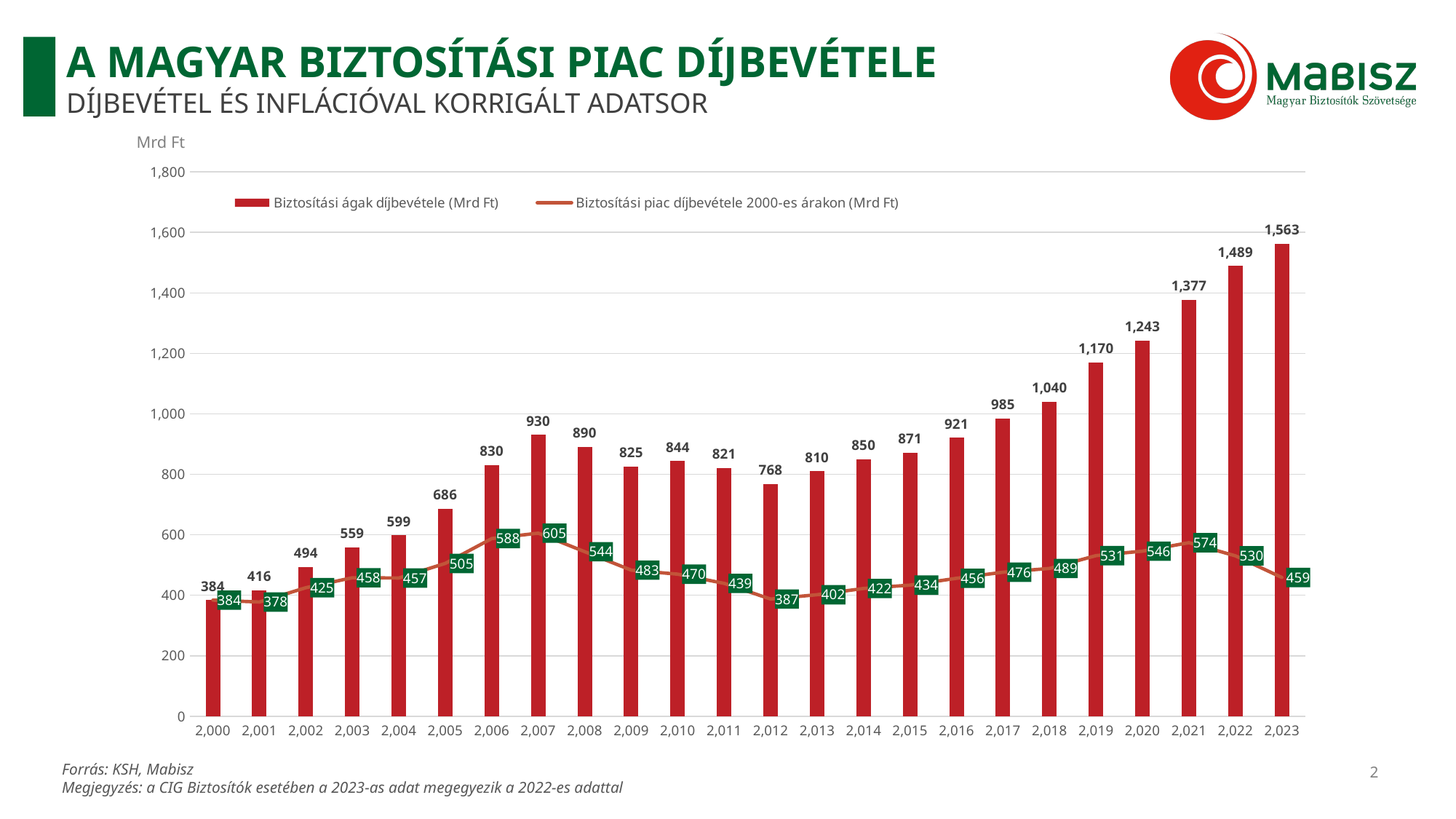
What is the value of the 'Biztosítási ágak díjbevétele (Mrd Ft)' bar for 2,012? 768 Which is larger: the 'Biztosítási ágak díjbevétele (Mrd Ft)' bar for 2,007 or for 2,008? 2,007 What unit is shown above the y axis of the chart? Mrd Ft What is the value of the 'Biztosítási piac díjbevétele 2000-es árakon (Mrd Ft)' line for 2,007? 605 How many series does the chart legend list? 2 What kind of chart is shown on the slide? Combined bar and line chart Which year has the lowest 'Biztosítási ágak díjbevétele (Mrd Ft)' bar? 2,000 Which year has the highest value on the 'Biztosítási piac díjbevétele 2000-es árakon (Mrd Ft)' line? 2,007 How many years are shown on the x axis of the chart? 24 What is the value of the 'Biztosítási ágak díjbevétele (Mrd Ft)' bar for 2,023? 1,563 Is the 'Biztosítási ágak díjbevétele (Mrd Ft)' bar for 2,018 greater or less than 1,000? greater What is the difference between the 'Biztosítási ágak díjbevétele (Mrd Ft)' bars for 2,023 and 2,022? 74